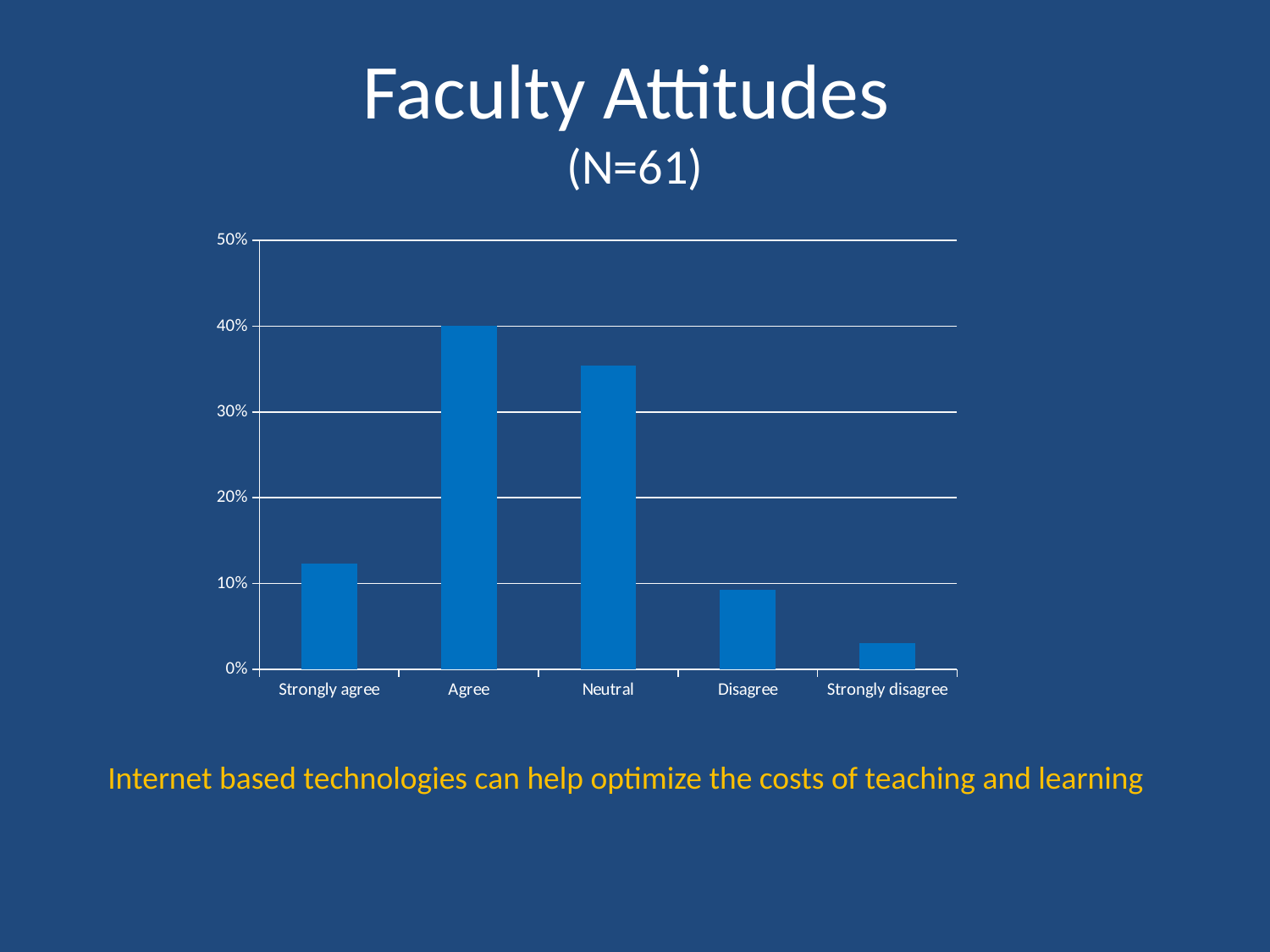
Which is larger, the value for Agree or the value for Neutral? Agree Which is larger, the value for Strongly agree or the value for Disagree? Strongly agree Is the value for Neutral greater or less than 40%? less Which response category has the highest value? Agree What is the sample size (N) given in the slide title? 61 Is the value for Strongly disagree greater or less than 10%? less Is the value for Strongly agree greater or less than 10%? greater What type of chart is shown on the slide? bar chart Which response category has the lowest value? Strongly disagree How many response categories are shown on the x axis? 5